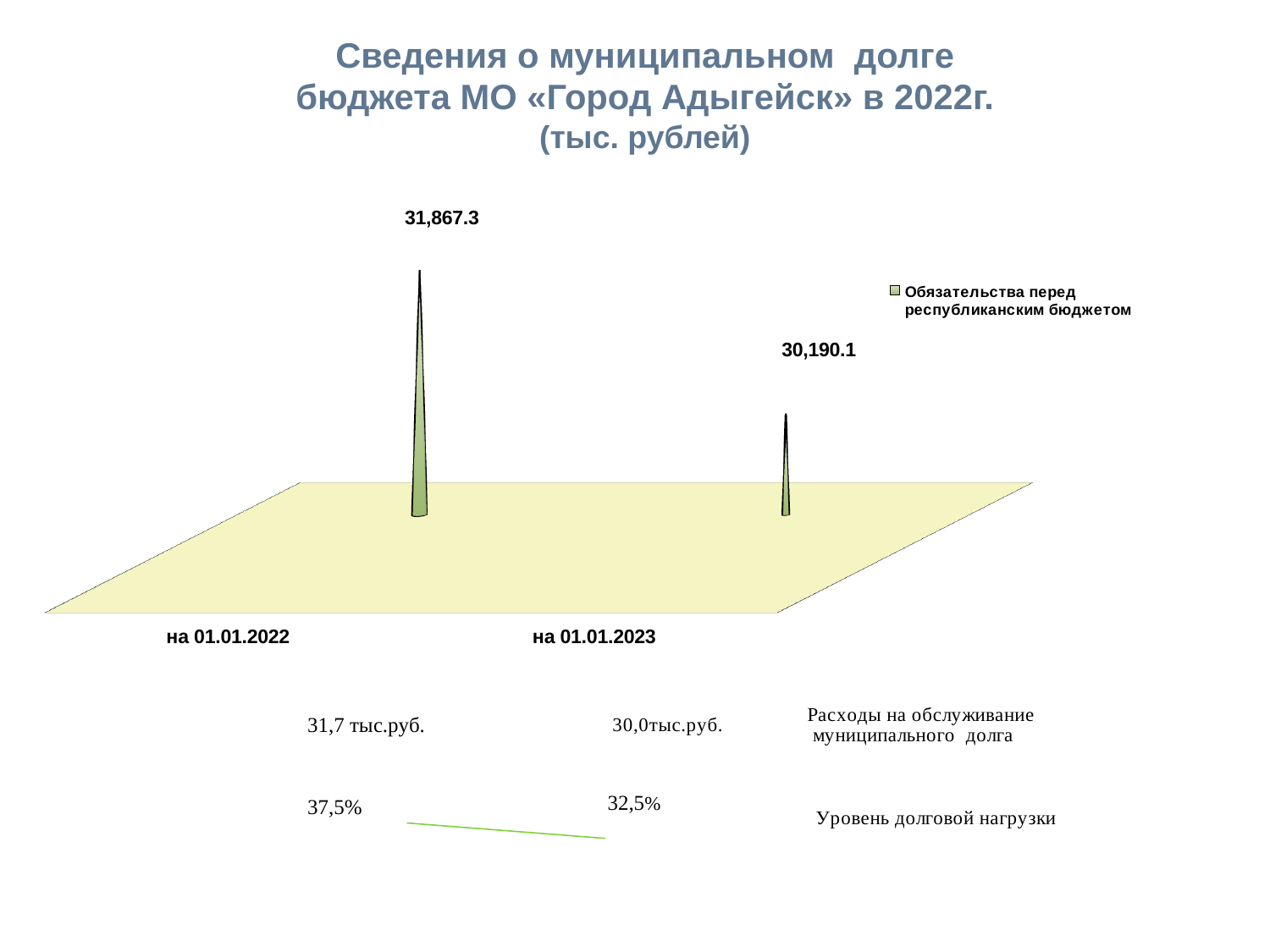
How many series does the chart's legend list? 1 What unit is stated in the chart's title? тыс. рублей Which category has the highest value in the chart? на 01.01.2022 How many categories are shown on the chart's x axis? 2 What series name is listed in the chart's legend? Обязательства перед республиканским бюджетом What is the value for "на 01.01.2022" in the chart? 31,867.3 What is the value for "на 01.01.2023" in the chart? 30,190.1 Which is larger: the value for "на 01.01.2022" or the value for "на 01.01.2023"? на 01.01.2022 Do the values rise or fall from "на 01.01.2022" to "на 01.01.2023"? fall What kind of chart is shown on the slide? bar chart Which category has the lowest value in the chart? на 01.01.2023 What is the difference between the values for "на 01.01.2022" and "на 01.01.2023"? 1,677.2